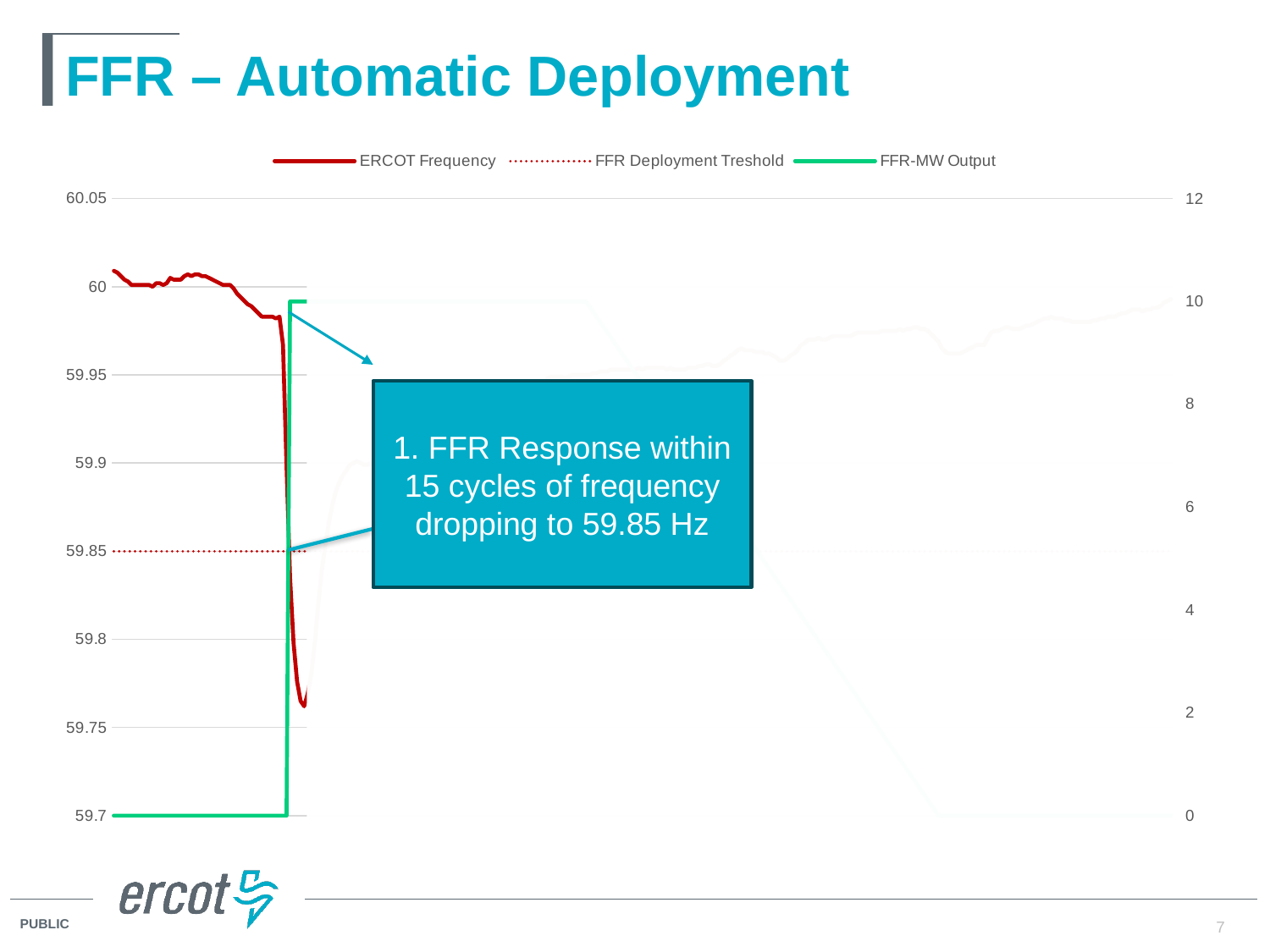
How many series does the legend list? 3 Is the ERCOT Frequency at the start of the chart greater or less than 59.95? greater Does the ERCOT Frequency line rise or fall just before the FFR-MW Output steps up? fall Which series is drawn as a dotted line in the legend? FFR Deployment Treshold What is the highest value shown on the left vertical axis? 60.05 Is the lowest point of the ERCOT Frequency line greater or less than 59.8? less What is the FFR-MW Output value on the right axis before the deployment step? 0 Is the FFR-MW Output after the deployment step greater or less than 8 on the right axis? greater At what frequency value does the FFR Deployment Treshold line sit on the left axis? 59.85 What kind of chart is shown on the slide? line chart What colour is the FFR-MW Output line? green